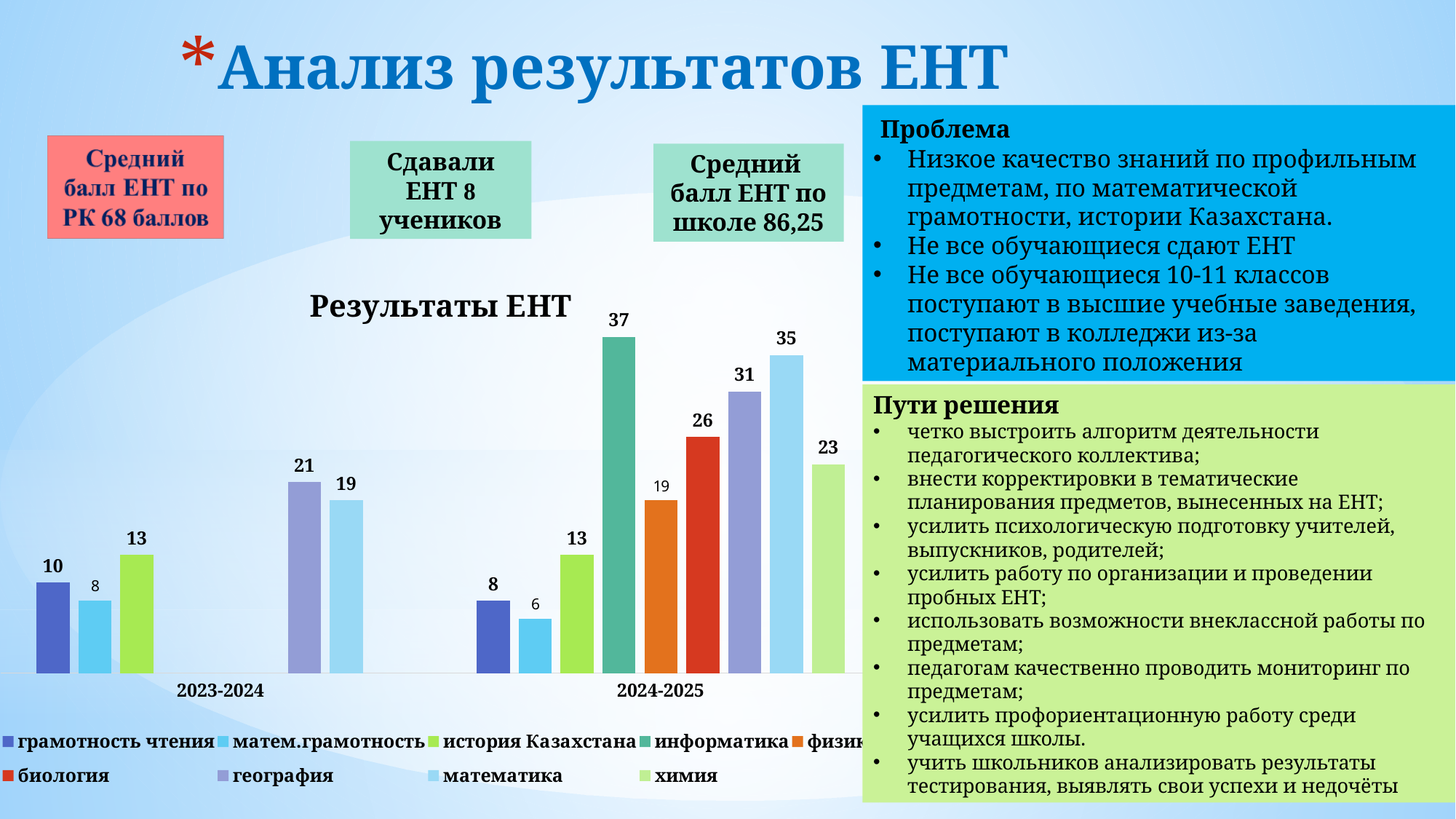
In the "Результаты ЕНТ" chart, what is the value for география in 2023-2024? 21 What is the title of the bar chart on the slide? Результаты ЕНТ What type of chart is "Результаты ЕНТ"? bar chart In the "Результаты ЕНТ" chart, what is the difference between математика in 2024-2025 and математика in 2023-2024? 16 In the "Результаты ЕНТ" chart, which subject has the highest value in 2024-2025? информатика How many year categories are shown on the x axis of the "Результаты ЕНТ" chart? 2 In the "Результаты ЕНТ" chart, which is larger: биология in 2024-2025 or география in 2024-2025? география In the "Результаты ЕНТ" chart, what is the value for информатика in 2024-2025? 37 In the "Результаты ЕНТ" chart, does the value for грамотность чтения rise or fall from 2023-2024 to 2024-2025? fall How many series does the legend of the "Результаты ЕНТ" chart list? 9 In the "Результаты ЕНТ" chart, what is the value for матем.грамотность in 2024-2025? 6 In the "Результаты ЕНТ" chart, which subject has the lowest value in 2023-2024? матем.грамотность